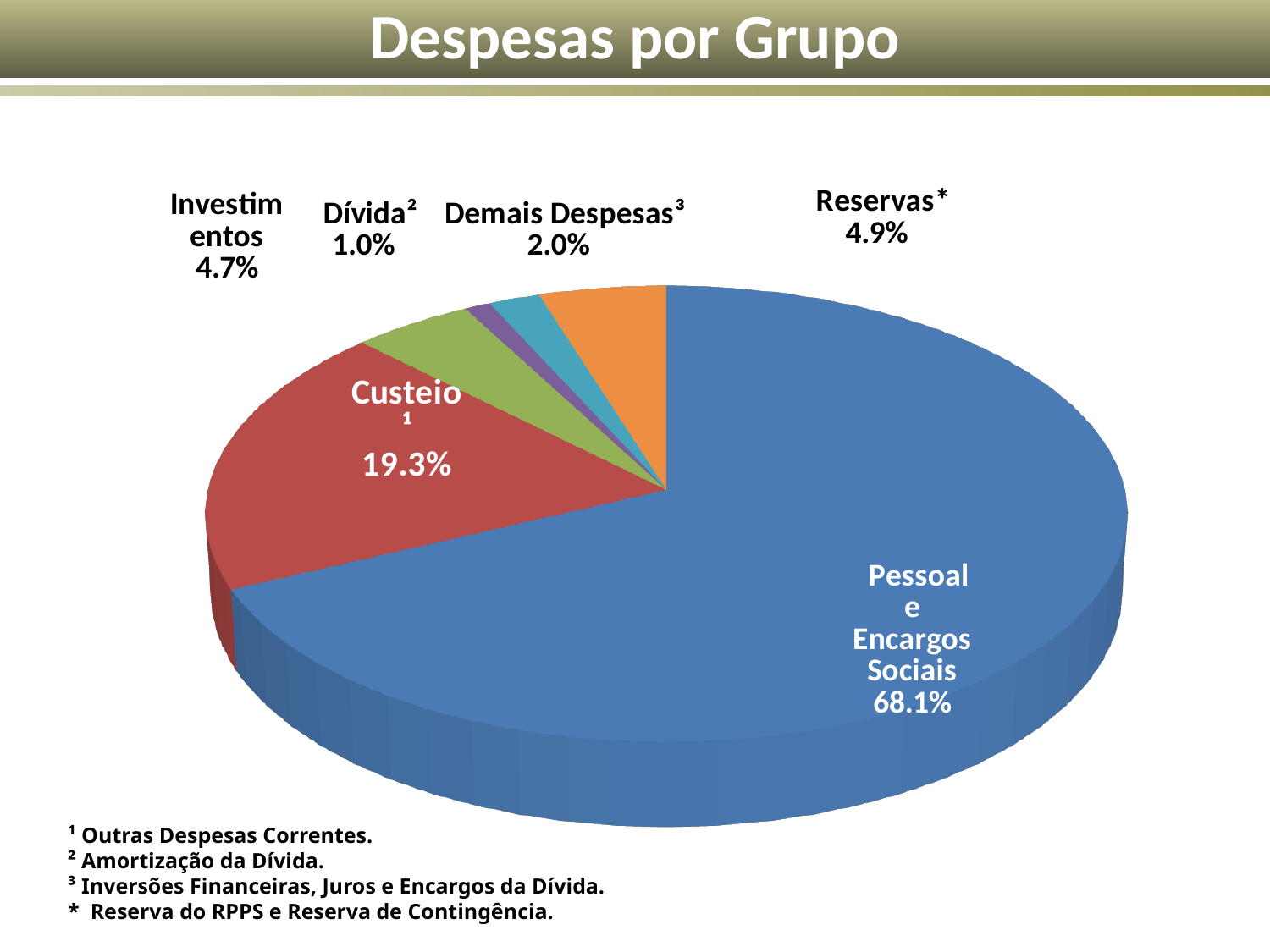
What is the title of the chart? Despesas por Grupo Which group has the smallest share of expenses? Dívida Which group has the largest share of expenses? Pessoal e Encargos Sociais What is the difference in percentage points between Pessoal e Encargos Sociais and Custeio? 48.8 What percentage of expenses is Reservas? 4.9% Which is larger, the share for Reservas or the share for Investimentos? Reservas What percentage of expenses is Investimentos? 4.7% What percentage of expenses is Custeio? 19.3% What type of chart is shown on the slide? Pie chart What percentage of expenses is Dívida? 1.0% How many groups are shown in the pie chart? 6 What percentage of expenses is Pessoal e Encargos Sociais? 68.1%